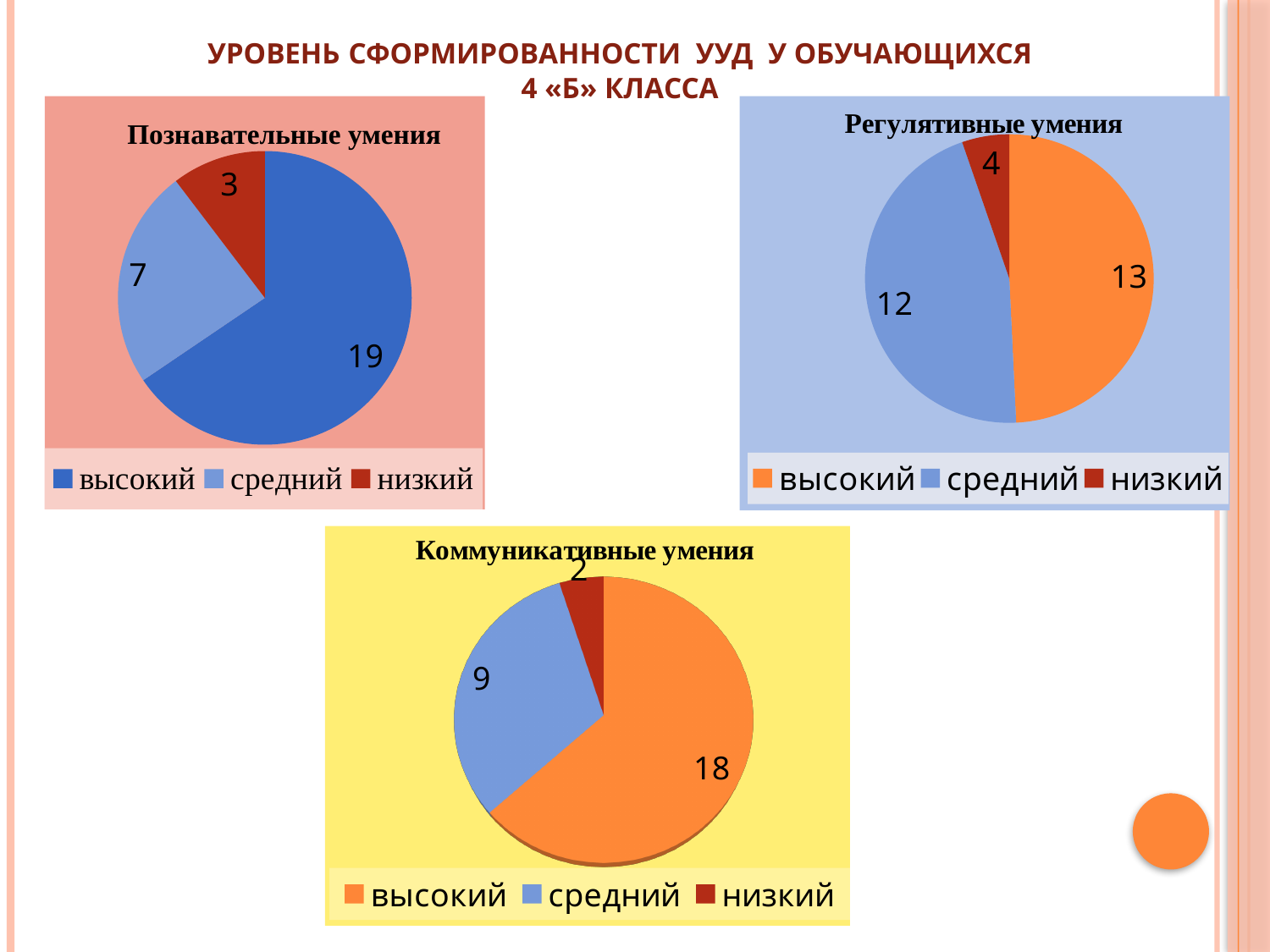
In the chart titled «Коммуникативные умения», which is larger, the value for «средний» or the value for «низкий»? средний How many slices does the chart titled «Коммуникативные умения» have? 3 In the chart titled «Регулятивные умения», what is the difference between the values for «высокий» and «низкий»? 9 In the chart titled «Познавательные умения», what is the value for «высокий»? 19 What kind of chart is the chart titled «Познавательные умения»? pie chart What is the total of all slices in the chart titled «Регулятивные умения»? 29 How many entries does the legend of the chart titled «Регулятивные умения» list? 3 In the chart titled «Познавательные умения», which category has the smallest slice? низкий In the chart titled «Познавательные умения», what is the difference between the values for «высокий» and «средний»? 12 In the chart titled «Коммуникативные умения», which category has the largest slice? высокий In the chart titled «Коммуникативные умения», what is the value for «низкий»? 2 In the chart titled «Регулятивные умения», what is the value for «средний»? 12